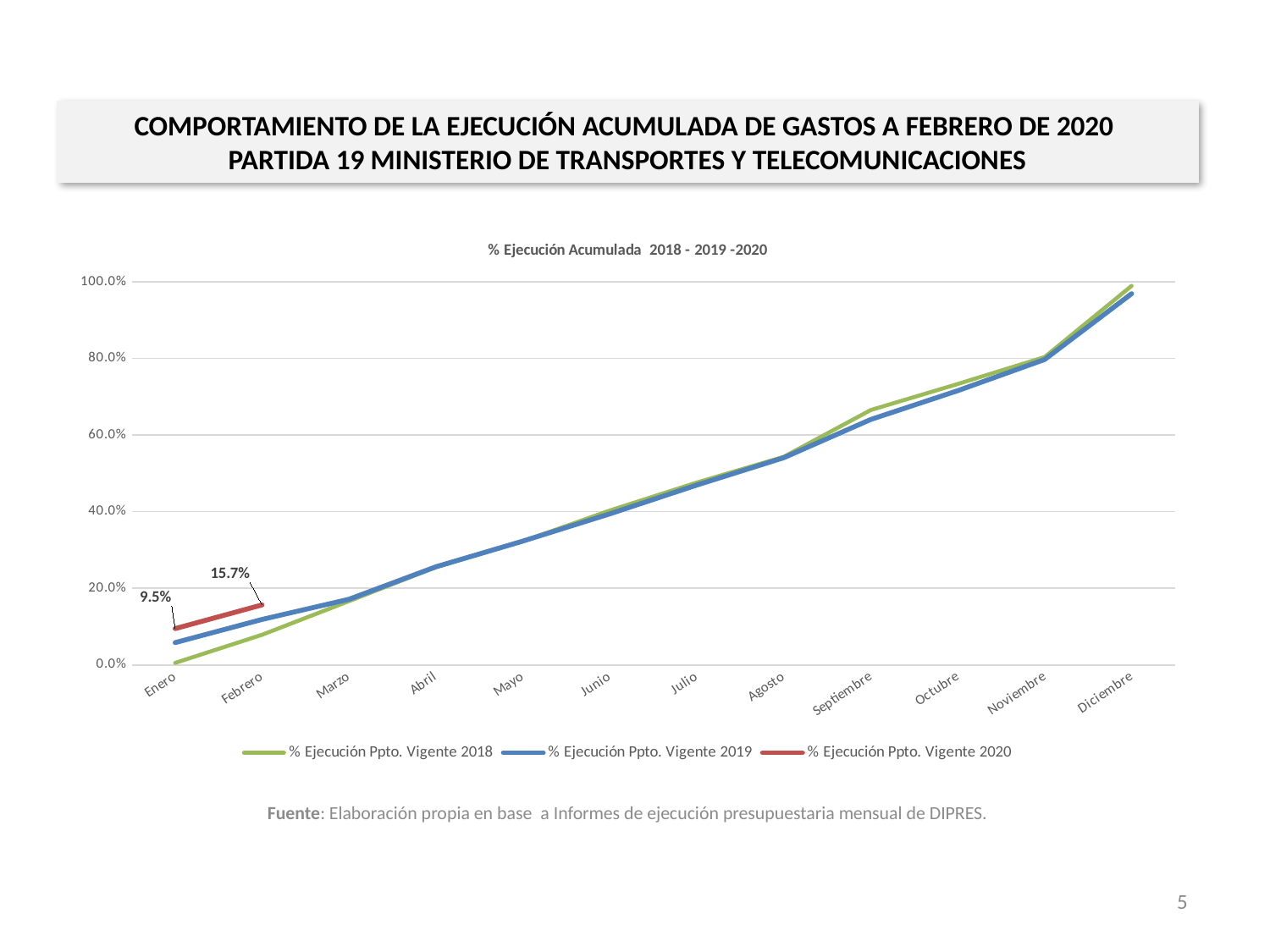
Is the value of % Ejecución Ppto. Vigente 2019 for Enero greater or less than 20.0%? less What is the title of the chart? % Ejecución Acumulada 2018 - 2019 -2020 Do the values of % Ejecución Ppto. Vigente 2019 rise or fall from Enero to Diciembre? rise What colour is the line for % Ejecución Ppto. Vigente 2020? red What is the value of % Ejecución Ppto. Vigente 2020 for Febrero? 15.7% What kind of chart is shown on the slide? line chart What is the difference between the Febrero and Enero values of % Ejecución Ppto. Vigente 2020? 6.2% For % Ejecución Ppto. Vigente 2020, which month has the higher value, Enero or Febrero? Febrero Is the value of % Ejecución Ppto. Vigente 2018 for Diciembre greater or less than 80.0%? greater How many months are shown along the x axis? 12 How many series does the legend list? 3 What is the value of % Ejecución Ppto. Vigente 2020 for Enero? 9.5%